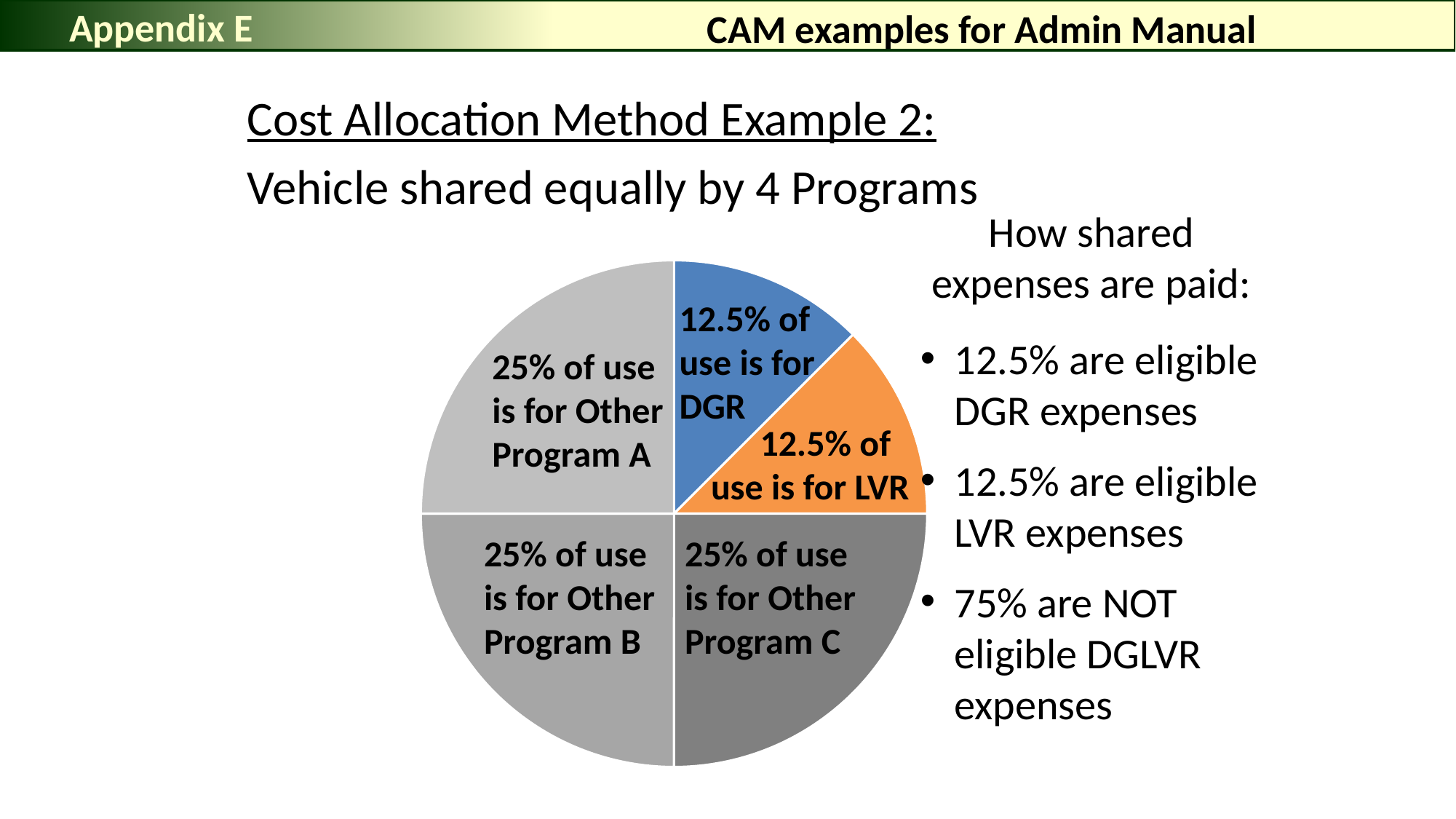
What kind of chart is shown on the slide? pie chart What is the combined share of use for DGR and LVR? 25% How many slices does the pie chart have? 5 What is the difference between the share for Other Program A and the share for LVR? 12.5% What share of use is for DGR according to the pie chart? 12.5% What is the combined share of use for Other Programs A, B and C? 75% What colour is the slice for DGR in the pie chart? blue What share of use is for Other Program C? 25% What share of use is for Other Program A? 25% What colour is the slice for LVR in the pie chart? orange Which is larger in the pie chart: the share for DGR or the share for Other Program B? Other Program B